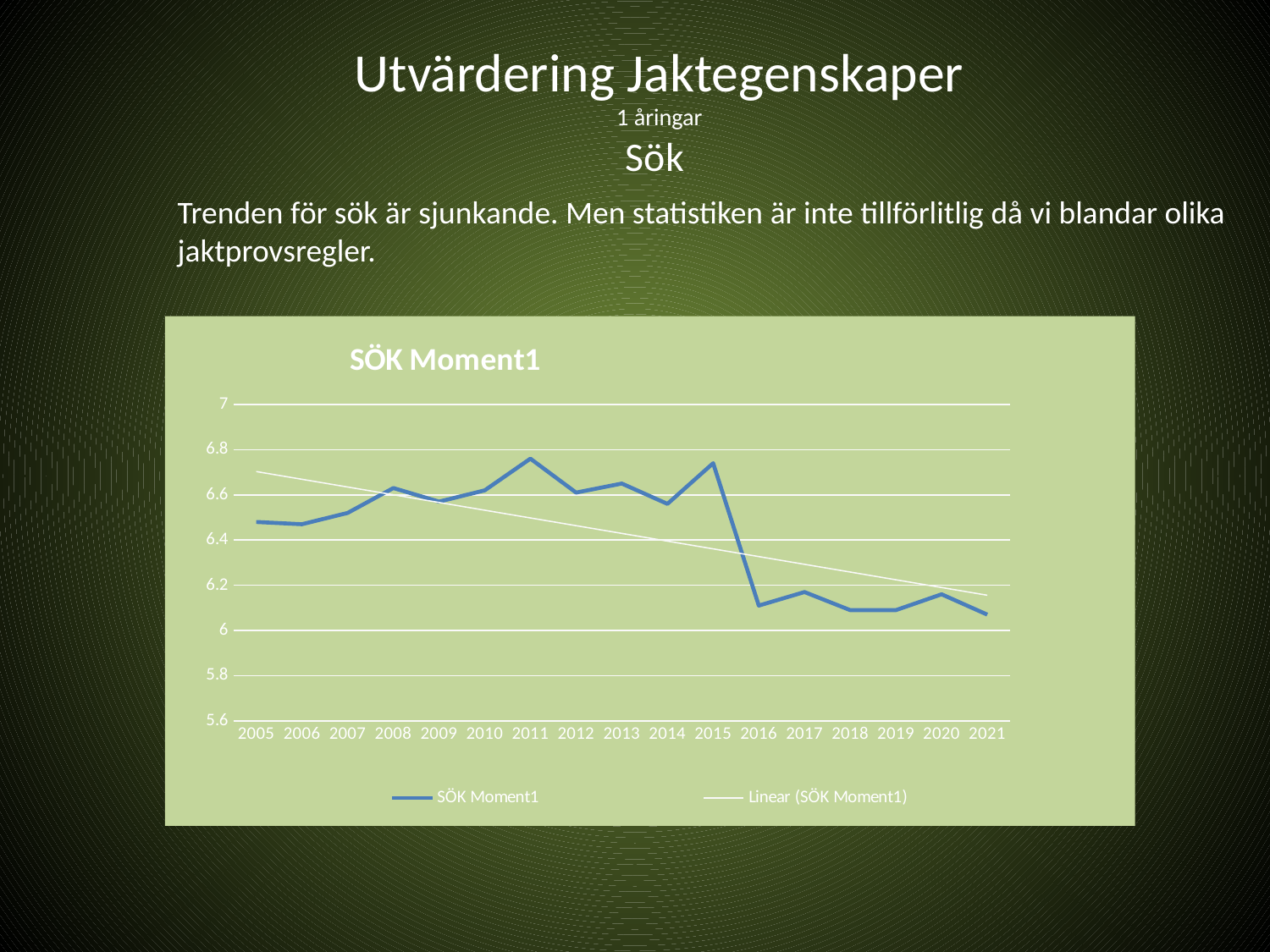
How many years are plotted along the x axis of the chart? 17 Do the values of the SÖK Moment1 series generally rise or fall from 2005 to 2021? fall Is the value for 2016 greater or less than 6.2? less How many series does the chart legend list? 2 Which year has the larger value, 2011 or 2016? 2011 Is the value for 2011 greater or less than 6.6? greater Which year has the larger value, 2008 or 2017? 2008 Is the value for 2005 greater or less than 6.4? greater What is the title of the chart? SÖK Moment1 What kind of chart is shown on the slide? line chart